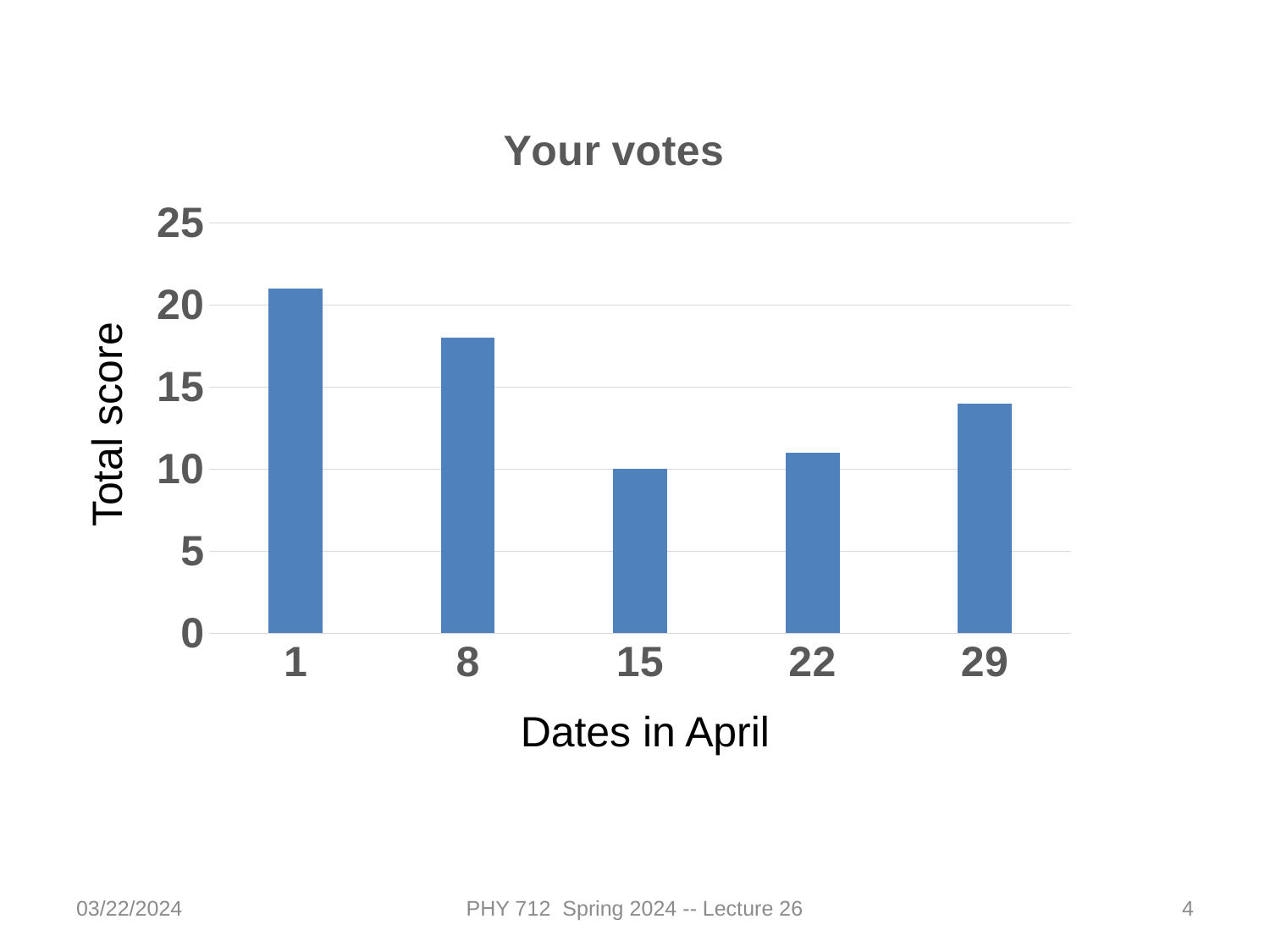
Which has a larger total score, April 8 or April 22? April 8 Which has a larger total score, April 1 or April 29? April 1 What kind of chart is shown on the slide? bar chart What is the title of the chart? Your votes Is the total score for April 22 greater or less than 15? less Is the total score for April 1 greater or less than 20? greater What is the label on the vertical axis of the chart? Total score Is the total score for April 8 greater or less than 15? greater Which date in April has the highest total score? 1 How many dates are plotted on the x axis of the chart? 5